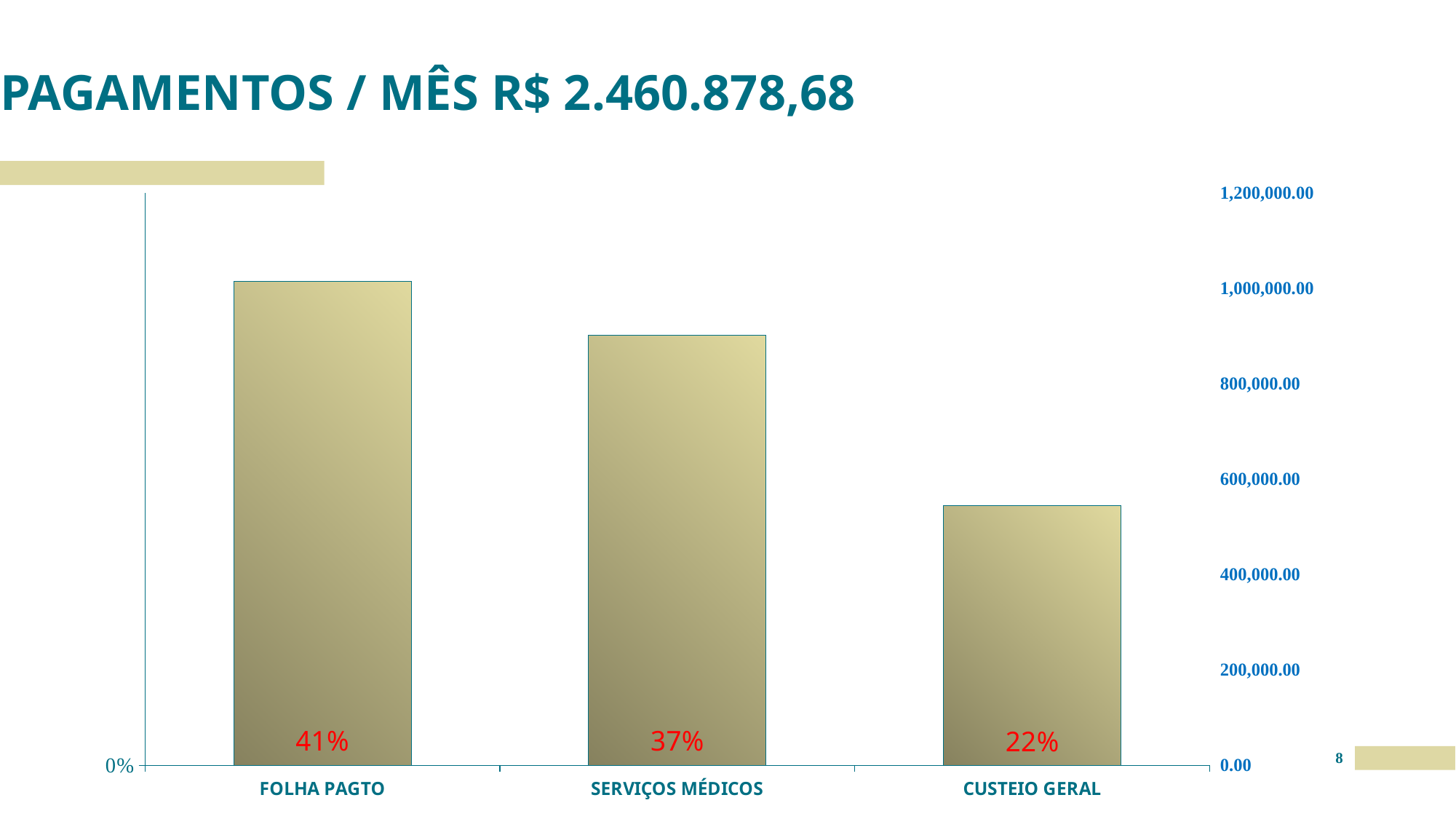
Which is larger, the value for SERVIÇOS MÉDICOS or the value for CUSTEIO GERAL? SERVIÇOS MÉDICOS Is the value for SERVIÇOS MÉDICOS greater or less than 800,000.00? greater Which category has the lowest bar? CUSTEIO GERAL What percentage is shown for CUSTEIO GERAL? 22% What kind of chart is shown on the slide? bar chart What percentage is shown for SERVIÇOS MÉDICOS? 37% What is the difference in percentage points between FOLHA PAGTO and SERVIÇOS MÉDICOS? 4 Is the value for CUSTEIO GERAL greater or less than 600,000.00? less How many categories are shown on the x axis? 3 Which category has the highest bar? FOLHA PAGTO What is the title of the slide? PAGAMENTOS / MÊS R$ 2.460.878,68 What percentage is shown for FOLHA PAGTO? 41%